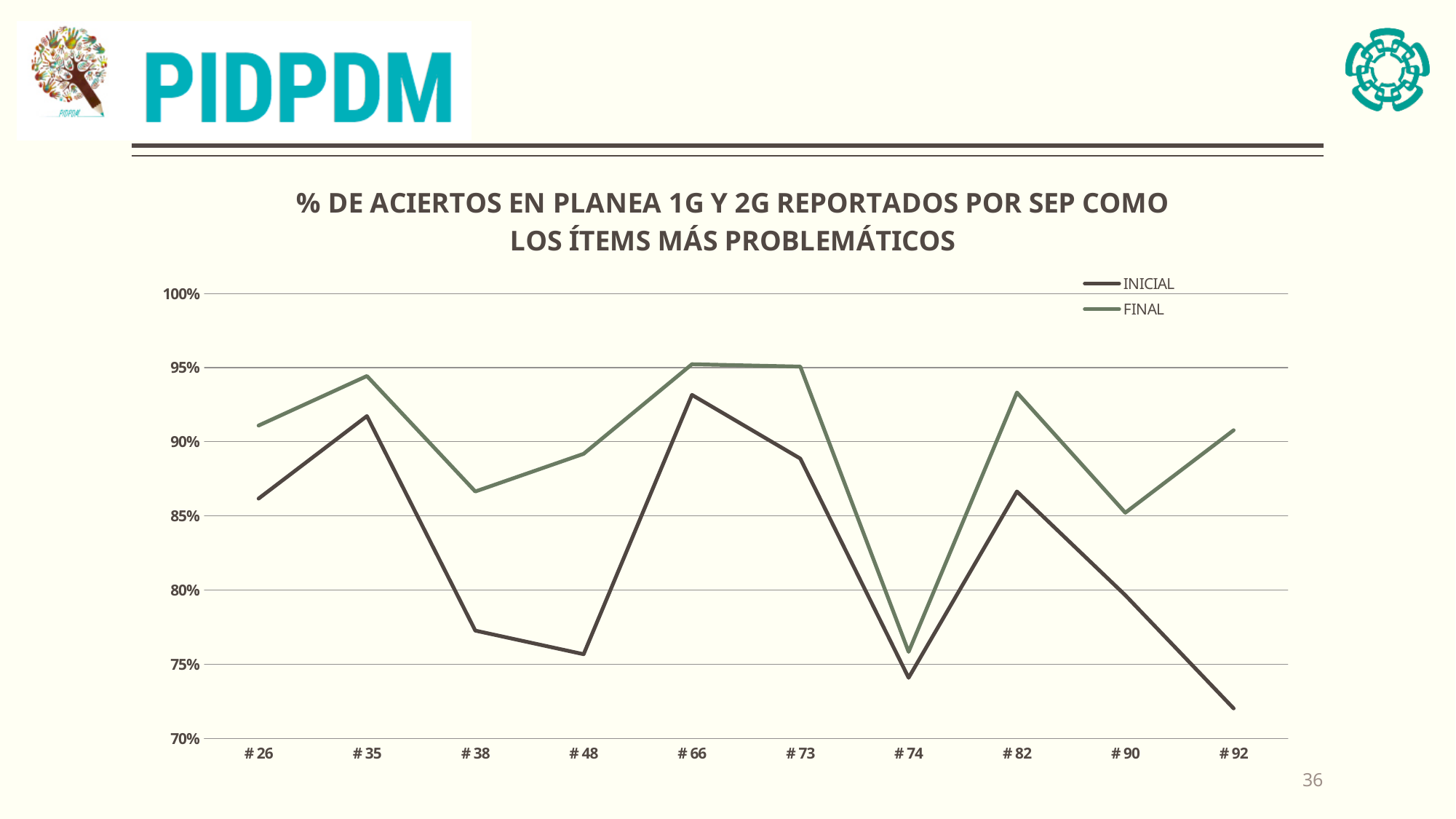
What kind of chart is shown on the slide? line chart How many items (categories) are plotted along the x axis? 10 Is the FINAL value for # 74 greater or less than 80%? less Is the INICIAL value for # 66 greater or less than 90%? greater At # 38, which series has the larger value, INICIAL or FINAL? FINAL How many series does the legend list? 2 Is the INICIAL value for # 92 greater or less than 75%? less Which item has the lowest INICIAL value? # 92 Which series is plotted in the darker line according to the legend? INICIAL Which item has the highest INICIAL value? # 66 Does the INICIAL line rise or fall from # 82 to # 92? fall Which item has the lowest FINAL value? # 74